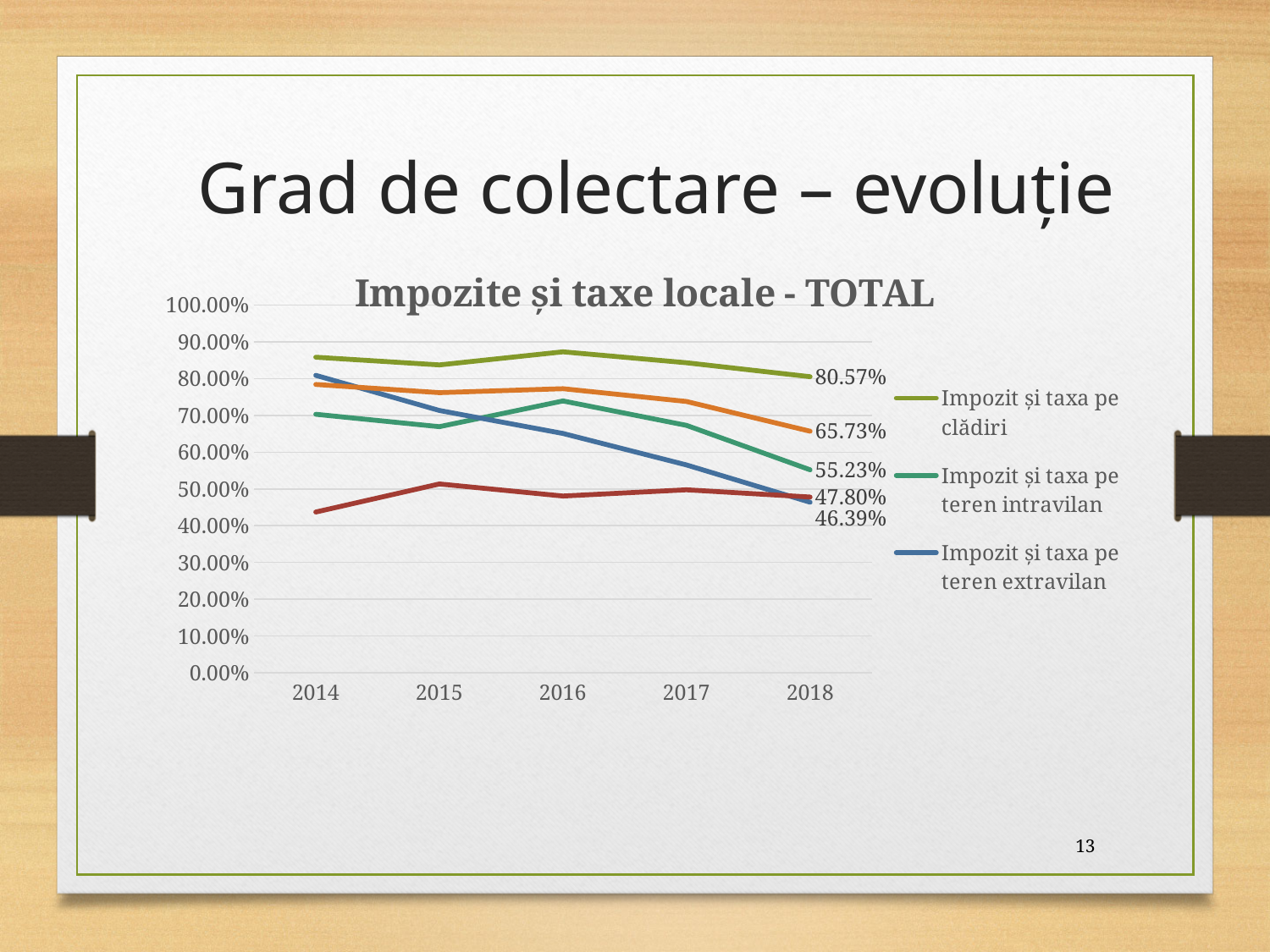
How many years are shown on the x axis? 5 Which series has the highest value in 2018? Impozit și taxa pe clădiri Does the value for Impozit și taxa pe teren extravilan rise or fall from 2014 to 2018? fall What is the value for Impozit și taxa pe teren intravilan in 2018? 55.23% How many series does the legend list? 3 Is the value for Impozit și taxa pe teren intravilan in 2014 greater or less than 80%? less What kind of chart is shown on the slide? line chart What is the difference between Impozit și taxa pe clădiri and Impozit și taxa pe teren intravilan in 2018? 25.34% Is the value for Impozit și taxa pe clădiri in 2016 greater or less than 80%? greater What is the value for Impozit și taxa pe teren extravilan in 2018? 46.39% What is the value for Impozit și taxa pe clădiri in 2018? 80.57% Which is larger in 2018: Impozit și taxa pe teren intravilan or Impozit și taxa pe teren extravilan? Impozit și taxa pe teren intravilan